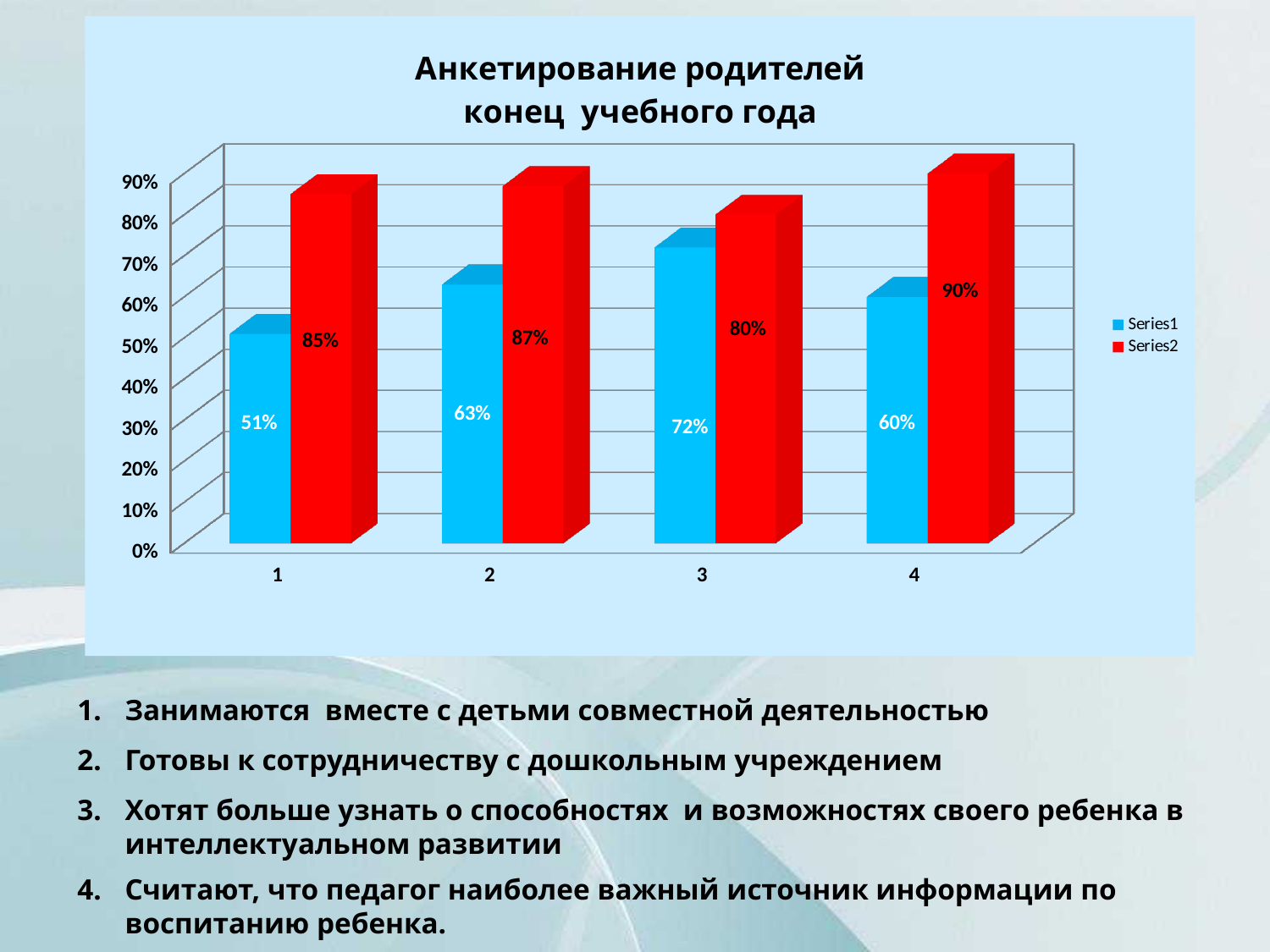
What is the difference between Series2 and Series1 for category 3? 8% How many series does the legend list? 2 What is the value of Series1 for category 3? 72% Which category has the lowest Series1 value? 1 Which is larger for category 2: Series1 or Series2? Series2 Which category has the highest Series2 value? 4 What colour are the Series2 bars? red What is the value of Series2 for category 4? 90% What is the value of Series1 for category 1? 51% How many categories are shown on the x axis? 4 What is the difference between Series2 and Series1 for category 1? 34% What kind of chart is shown on the slide? bar chart